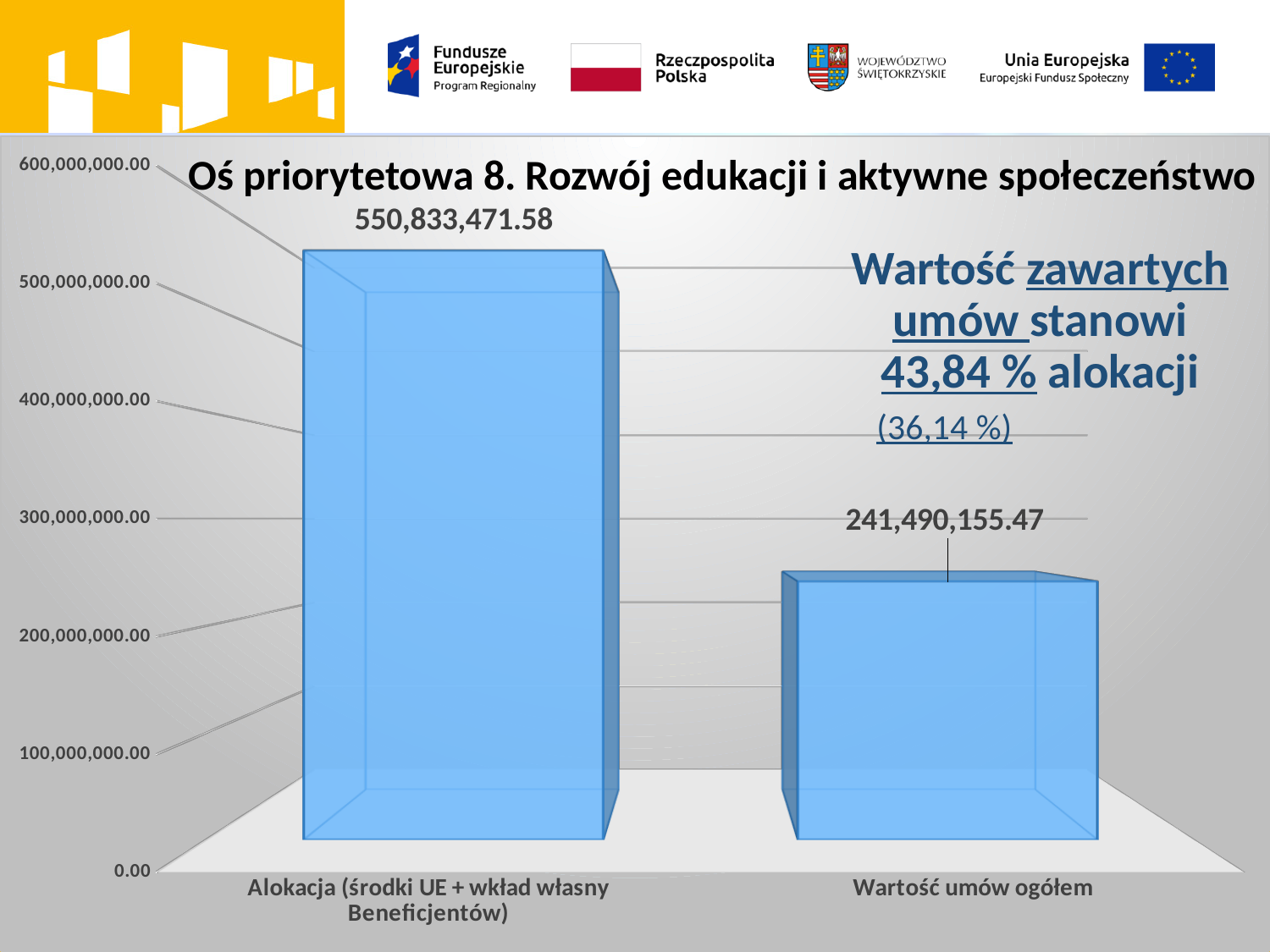
What is the value of the bar for 'Wartość umów ogółem'? 241,490,155.47 Which category has the highest value? Alokacja (środki UE + wkład własny Beneficjentów) Is the value for 'Alokacja (środki UE + wkład własny Beneficjentów)' greater or less than 500,000,000.00? greater According to the text on the slide, what percentage of the allocation does the value of concluded contracts represent? 43,84 % Is the value for 'Wartość umów ogółem' greater or less than 300,000,000.00? less Which category has the lowest value? Wartość umów ogółem How many categories are shown on the chart? 2 What is the difference between the value for 'Alokacja (środki UE + wkład własny Beneficjentów)' and the value for 'Wartość umów ogółem'? 309,343,316.11 What kind of chart is shown on the slide? bar chart What is the value of the bar for 'Alokacja (środki UE + wkład własny Beneficjentów)'? 550,833,471.58 Which is larger: the value for 'Alokacja (środki UE + wkład własny Beneficjentów)' or the value for 'Wartość umów ogółem'? Alokacja (środki UE + wkład własny Beneficjentów) What is the title of the chart? Oś priorytetowa 8. Rozwój edukacji i aktywne społeczeństwo